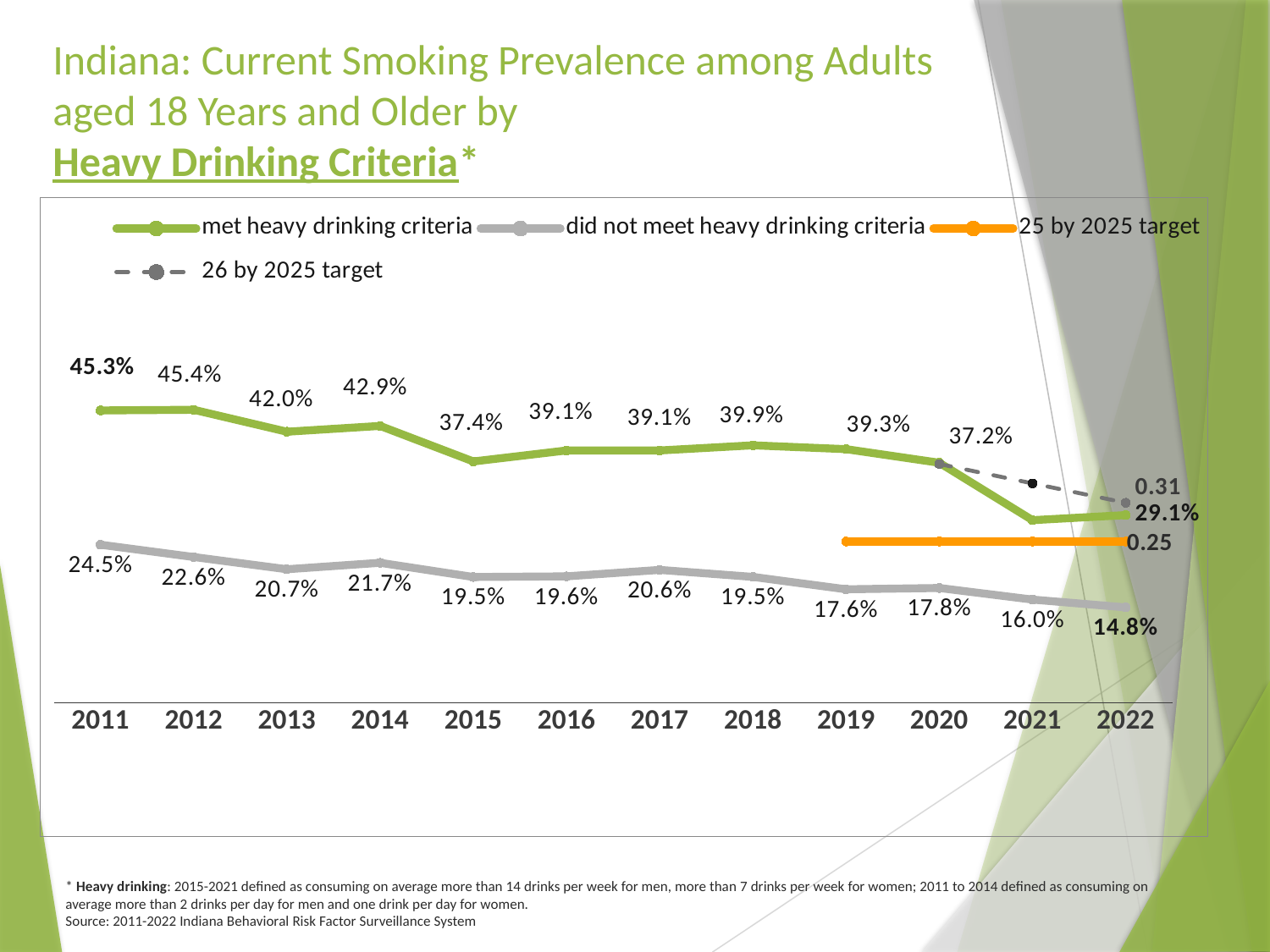
Does the smoking prevalence for adults who met heavy drinking criteria rise or fall overall from 2011 to 2022? fall What is the difference in percentage points between the 2022 values for those who met and those who did not meet heavy drinking criteria? 14.3 percentage points In which year was the smoking prevalence for adults who did not meet heavy drinking criteria the lowest? 2022 How many years are shown on the x axis? 12 What was the smoking prevalence among adults who did not meet heavy drinking criteria in 2017? 20.6% Which group had the higher smoking prevalence in 2015: those who met heavy drinking criteria or those who did not? met heavy drinking criteria What was the smoking prevalence among adults who met heavy drinking criteria in 2020? 37.2% How many series does the legend list? 4 What was the smoking prevalence among adults who met heavy drinking criteria in 2011? 45.3% What kind of chart is shown on the slide? line chart What was the smoking prevalence among adults who did not meet heavy drinking criteria in 2022? 14.8% In which year was the smoking prevalence for adults who did not meet heavy drinking criteria the highest? 2011